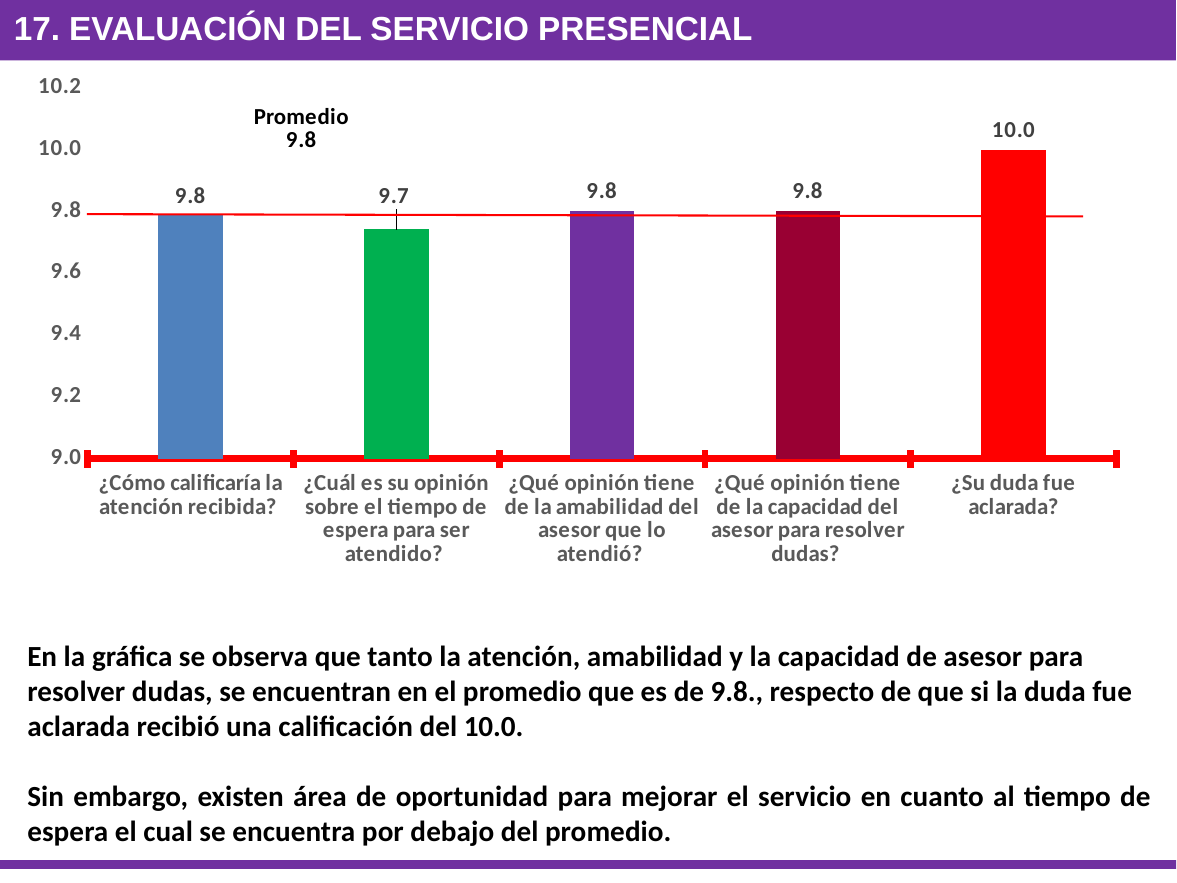
Which category has the highest value? ¿Su duda fue aclarada? What average (Promedio) value is marked by the horizontal line on the chart? 9.8 What is the difference between the value for "¿Su duda fue aclarada?" and the value for "¿Cuál es su opinión sobre el tiempo de espera para ser atendido?"? 0.3 What is the value for "¿Qué opinión tiene de la amabilidad del asesor que lo atendió?"? 9.8 Is the value for "¿Cuál es su opinión sobre el tiempo de espera para ser atendido?" greater or less than 9.8? less How many categories are shown on the x axis? 5 What is the value for "¿Cuál es su opinión sobre el tiempo de espera para ser atendido?"? 9.7 Which category has the lowest value? ¿Cuál es su opinión sobre el tiempo de espera para ser atendido? What is the value for "¿Cómo calificaría la atención recibida?"? 9.8 What is the value for "¿Su duda fue aclarada?"? 10.0 Which is larger: the value for "¿Su duda fue aclarada?" or the value for "¿Qué opinión tiene de la capacidad del asesor para resolver dudas?"? ¿Su duda fue aclarada? What kind of chart is shown on the slide? bar chart